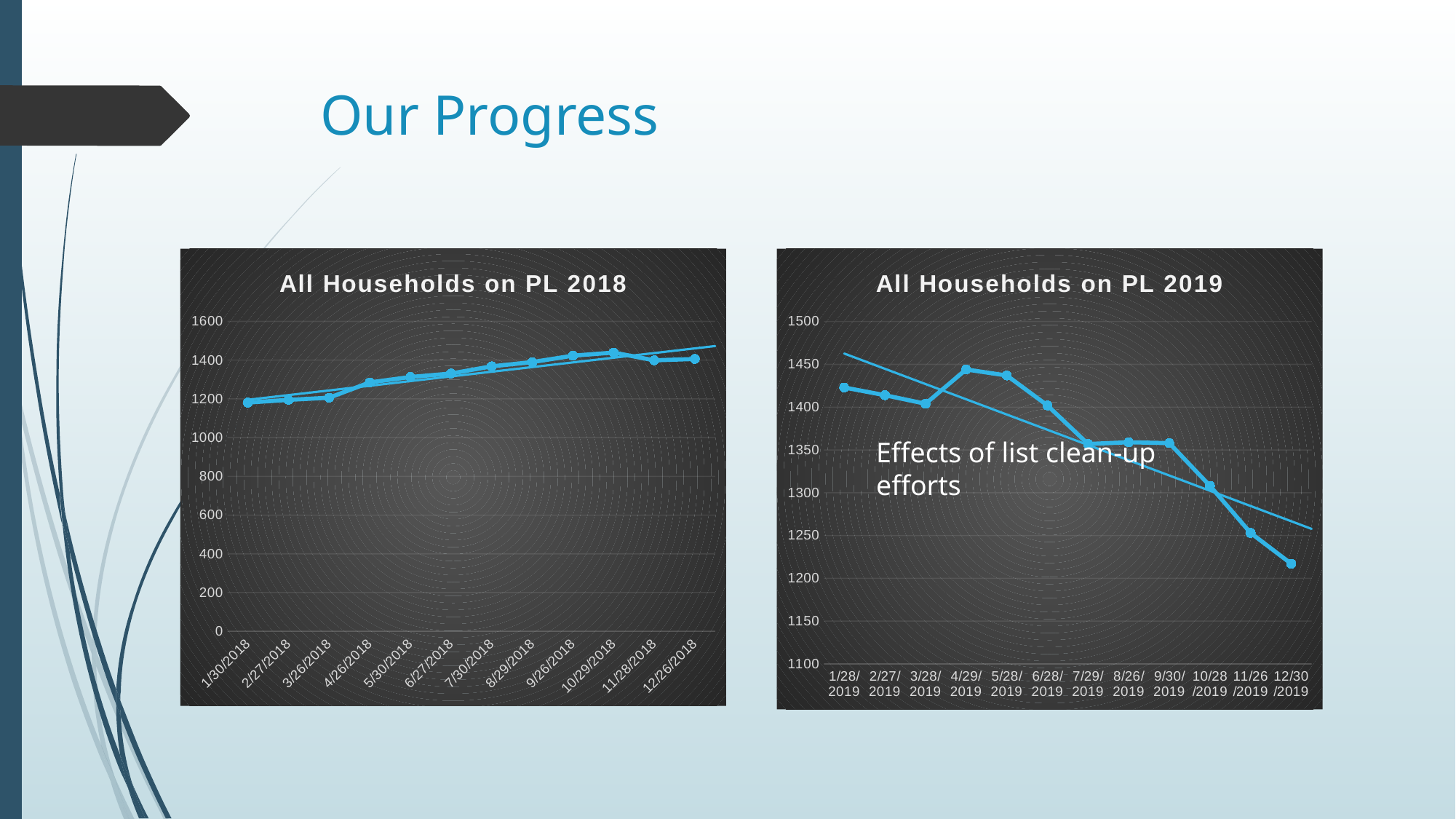
On the "All Households on PL 2019" chart, is the value for 12/30/2019 greater or less than 1250? less On the "All Households on PL 2019" chart, which date has the lowest value? 12/30/2019 On the "All Households on PL 2018" chart, which date has the lowest value? 1/30/2018 On the "All Households on PL 2019" chart, which is larger, the value for 1/28/2019 or the value for 12/30/2019? 1/28/2019 On the "All Households on PL 2019" chart, which date has the highest value? 4/29/2019 On the "All Households on PL 2019" chart, do the values generally rise or fall from left to right? fall On the "All Households on PL 2019" chart, is the value for 4/29/2019 greater or less than 1400? greater What kind of chart is the "All Households on PL 2018" chart? line chart What is the title of the chart on the right side of the slide? All Households on PL 2019 On the "All Households on PL 2018" chart, is the value for 10/29/2018 greater or less than 1200? greater On the "All Households on PL 2018" chart, do the values generally rise or fall from left to right? rise How many data points are plotted on the "All Households on PL 2019" chart? 12